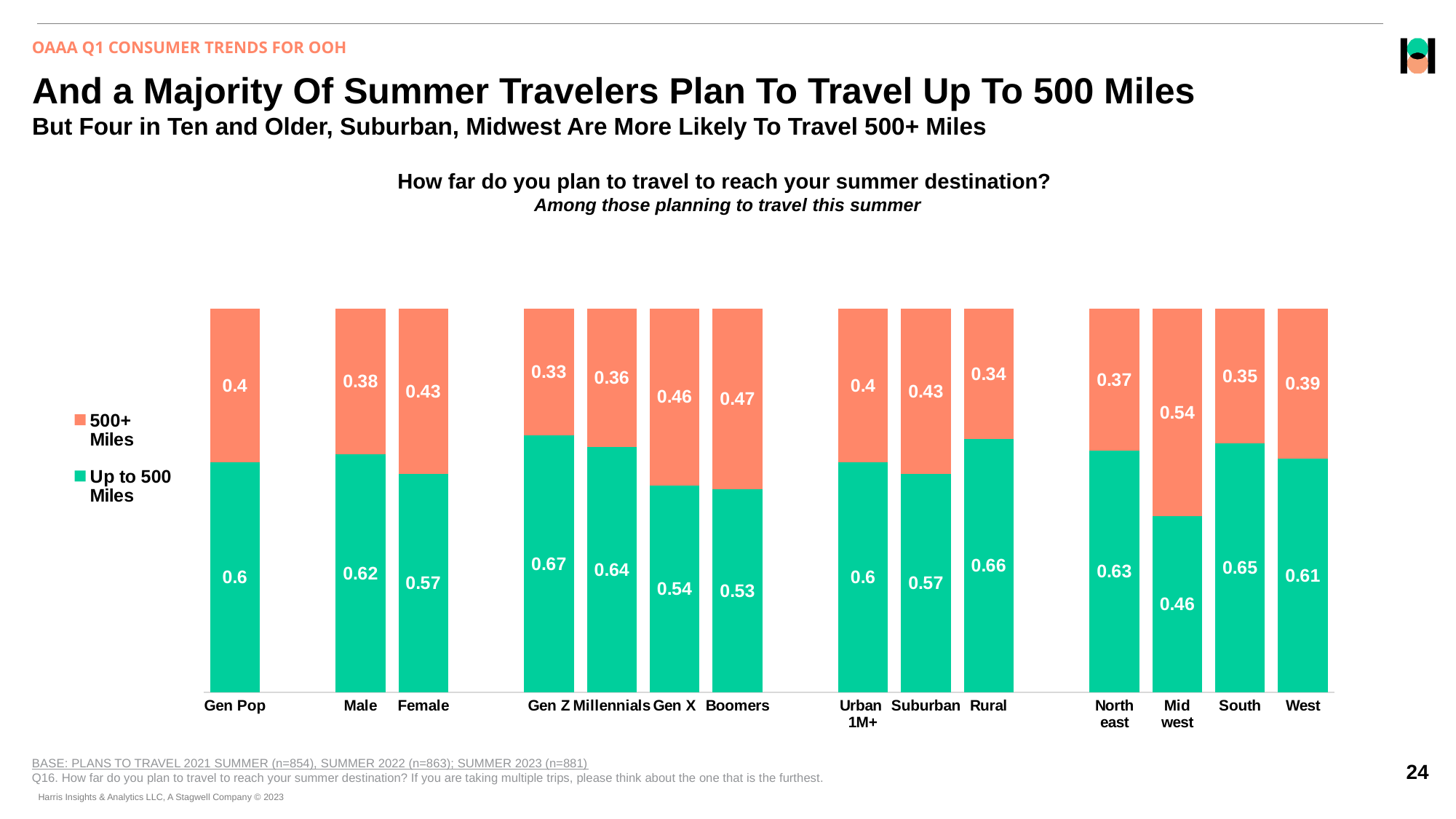
Which category has the lowest value for "500+ Miles"? Gen Z How many series does the legend list? 2 What is the value for "500+ Miles" for Boomers? 0.47 Which is larger: the "Up to 500 Miles" value for Rural or for Suburban? Rural What is the value for "Up to 500 Miles" for Gen Z? 0.67 Which category has the lowest value for "Up to 500 Miles"? Mid west How many categories are shown on the x axis? 14 What is the difference between the "Up to 500 Miles" values for Gen Z and Boomers? 0.14 What kind of chart is shown on the slide? Stacked bar chart What is the value for "500+ Miles" for Mid west? 0.54 What is the total of the stacked bar for Gen Pop? 1 Which category has the highest value for "Up to 500 Miles"? Gen Z